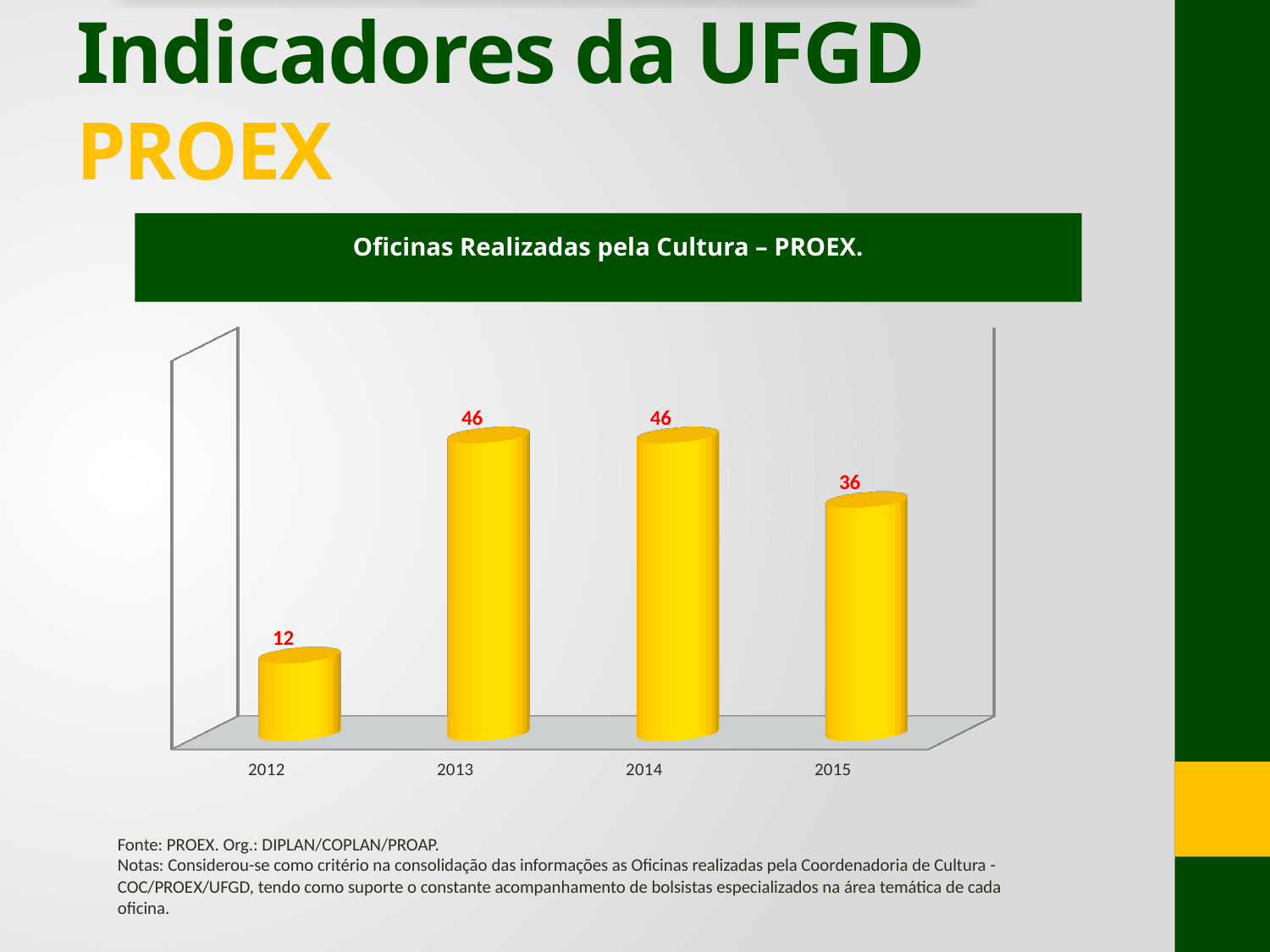
Which year has the lowest value? 2012 What is the value for 2013? 46 What is the value for 2012? 12 Which is larger, the value for 2015 or the value for 2012? 2015 What is the title of the chart? Oficinas Realizadas pela Cultura – PROEX. What kind of chart is shown? Bar chart What is the difference between the values for 2014 and 2015? 10 Do 2013 and 2014 have the same value? Yes What is the difference between the values for 2013 and 2012? 34 Does the value rise or fall from 2014 to 2015? Fall How many years are shown on the x axis? 4 What is the value for 2015? 36